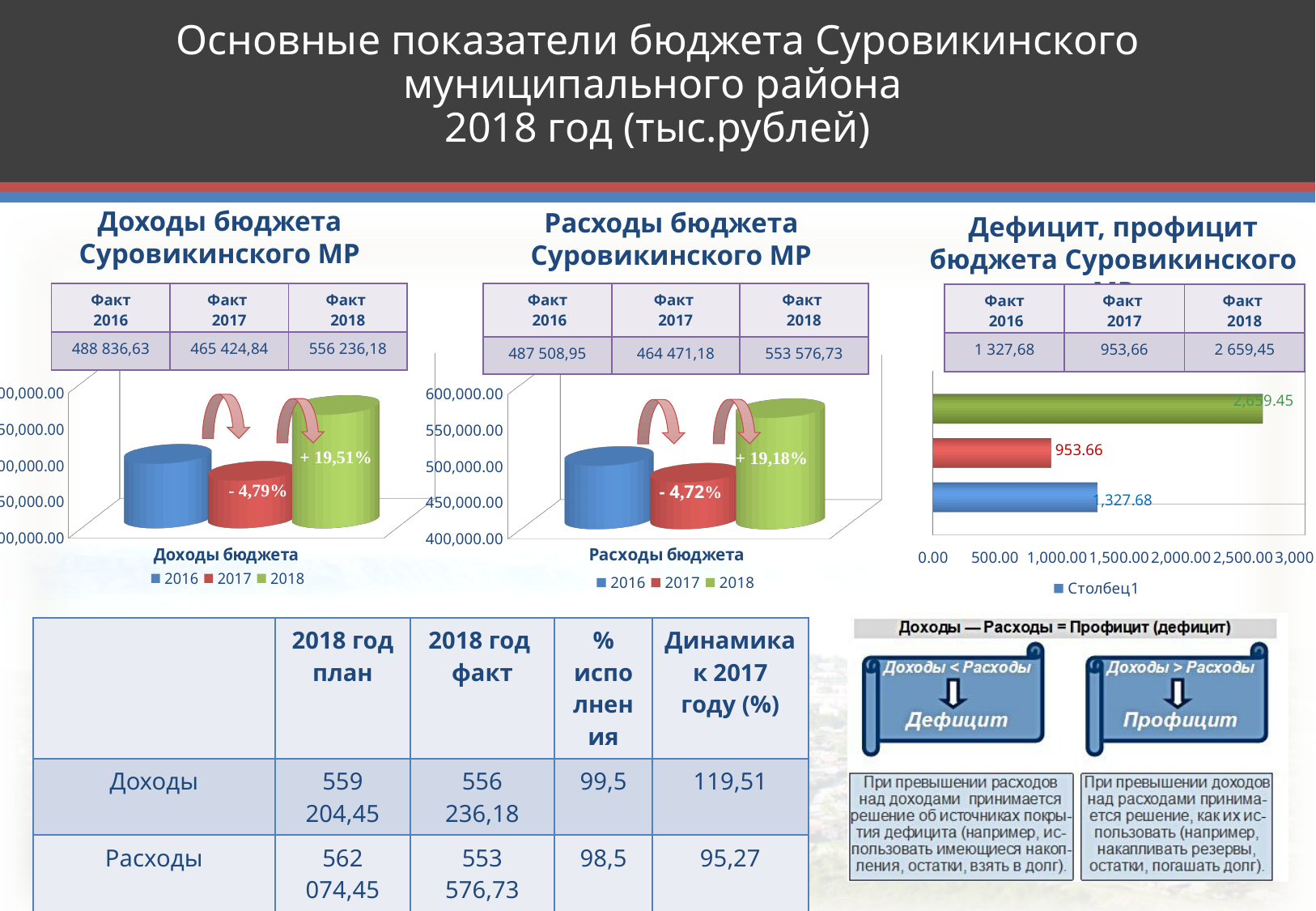
On the 'Дефицит, профицит бюджета Суровикинского МР' chart, what is the value of the red (middle) bar? 953.66 On the 'Дефицит, профицит бюджета Суровикинского МР' chart, which bar has the highest value? The green (top) bar, 2,659.45 On the 'Доходы бюджета Суровикинского МР' chart, what percentage change is labelled on the 2018 bar? + 19,51% How many series does the legend of the 'Доходы бюджета Суровикинского МР' chart list? 3 On the 'Дефицит, профицит бюджета Суровикинского МР' chart, what is the value of the green (top) bar? 2,659.45 On the 'Дефицит, профицит бюджета Суровикинского МР' chart, what legend entry is shown? Столбец1 On the 'Расходы бюджета Суровикинского МР' chart, what percentage change is labelled on the 2017 bar? - 4,72% On the 'Дефицит, профицит бюджета Суровикинского МР' chart, what is the difference between the green bar and the blue bar? 1,331.77 On the 'Расходы бюджета Суровикинского МР' chart, is the 2017 bar greater or less than 500,000.00? less What kind of chart is the 'Доходы бюджета Суровикинского МР' chart? Bar chart On the 'Дефицит, профицит бюджета Суровикинского МР' chart, what is the value of the blue (bottom) bar? 1,327.68 On the 'Дефицит, профицит бюджета Суровикинского МР' chart, which bar has the lowest value? The red (middle) bar, 953.66